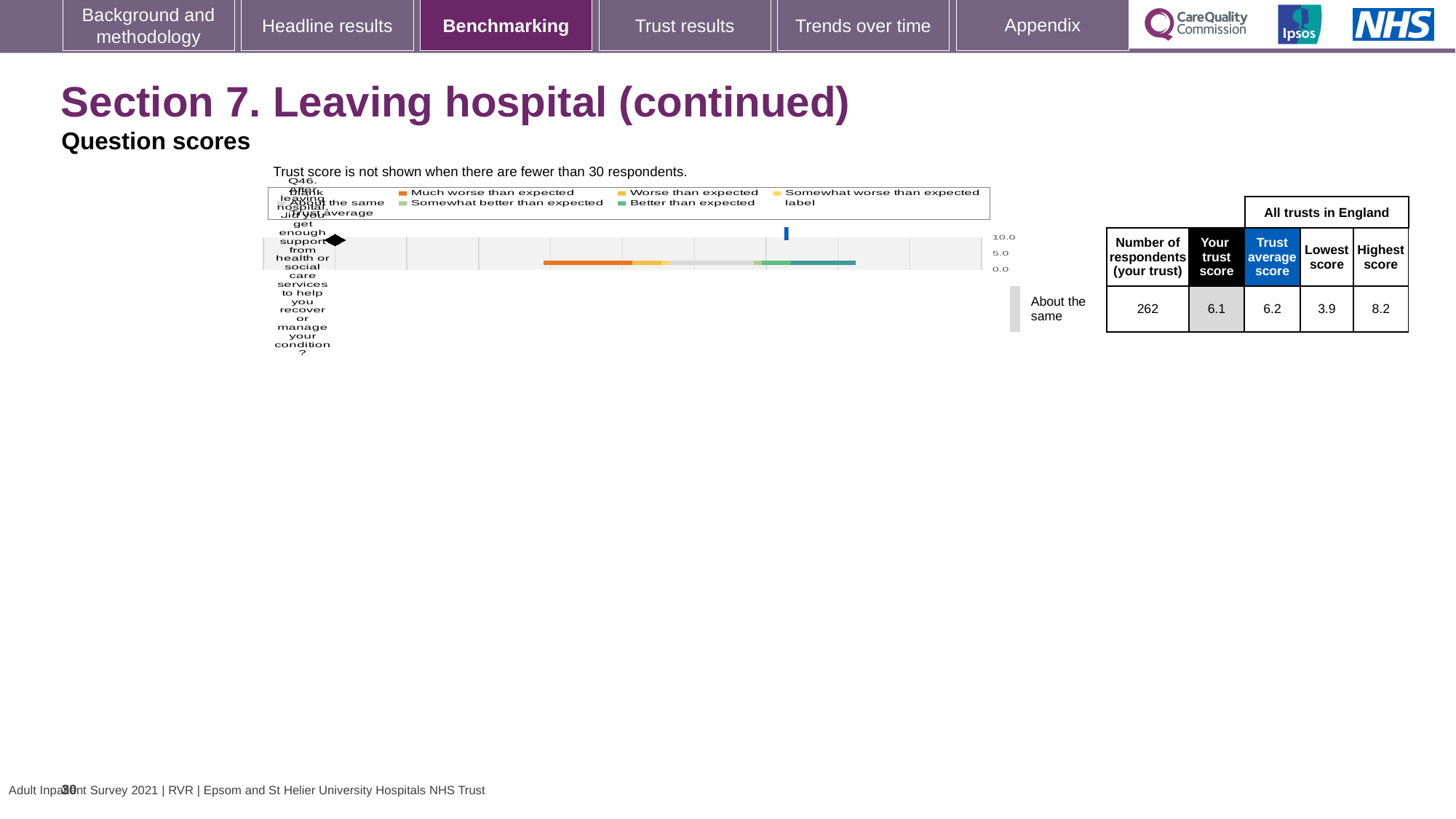
Is the trust score for Q46 greater or less than 5.0 on the chart axis? greater What is the difference between the trust average score and the trust score for Q46? 0.1 What is the lowest score among all trusts in England for Q46? 3.9 How many respondents from the trust answered Q46? 262 What kind of chart is used to show the Q46 benchmarking result? Bar chart What is the maximum value shown on the chart's axis? 10.0 Which is larger for Q46: the trust score or the trust average score? Trust average score What is the difference between the highest and lowest scores for Q46 across all trusts in England? 4.3 How is the trust's Q46 result categorised relative to other trusts? About the same What is the trust score for Q46 shown on the slide? 6.1 What is the highest score among all trusts in England for Q46? 8.2 What is the trust average score for Q46 across all trusts in England? 6.2